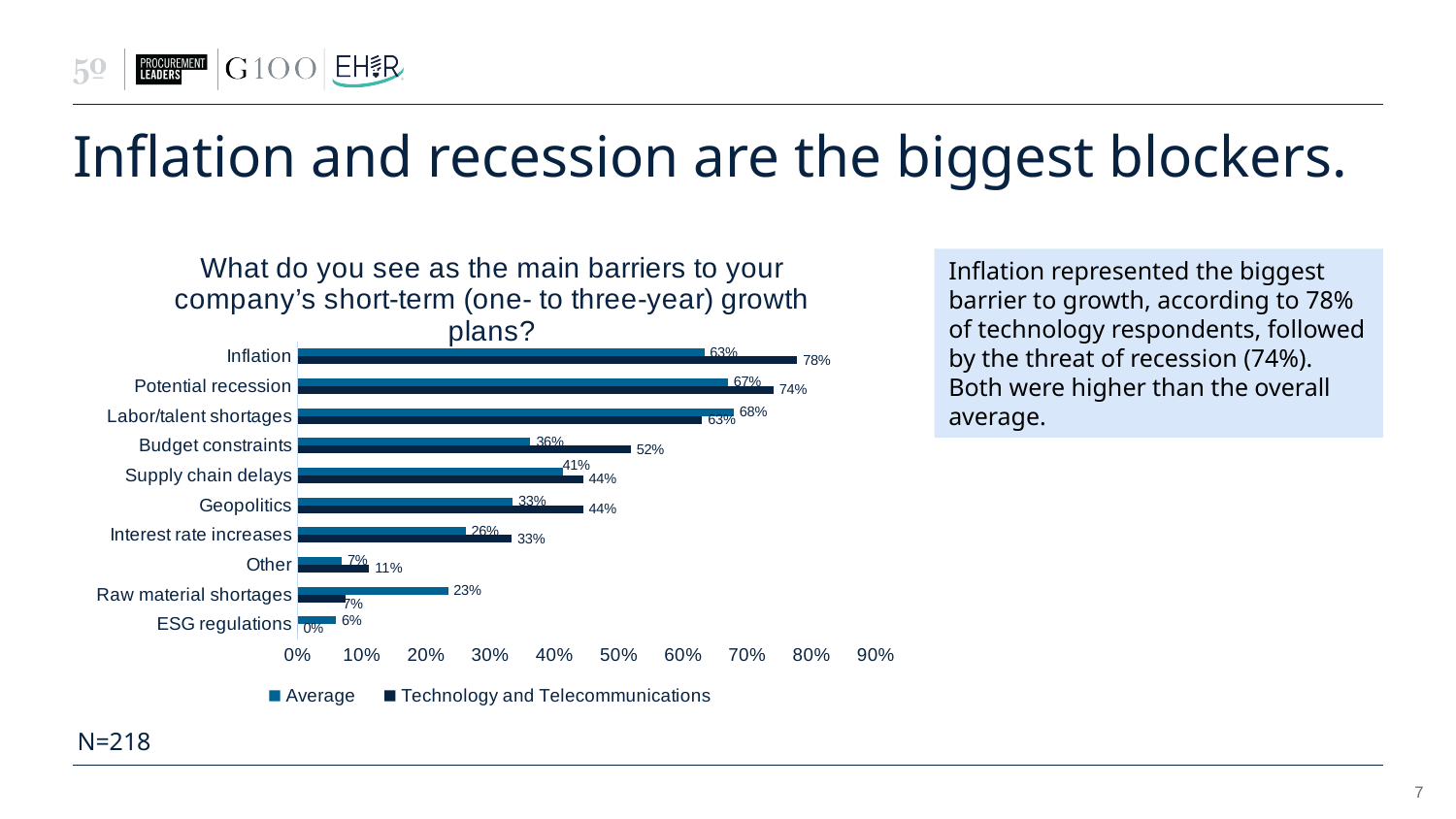
Which barrier has the highest Technology and Telecommunications value? Inflation What kind of chart is shown on the slide? Bar chart What is the Average value for Raw material shortages? 23% What is the difference between the Technology and Telecommunications value and the Average value for Inflation? 15% What is the Technology and Telecommunications value for ESG regulations? 0% What is the Technology and Telecommunications value for Budget constraints? 52% How many barrier categories are shown in the chart? 10 What is the Average value for Potential recession? 67% How many series does the legend list? 2 Which barrier has the lowest Average value? ESG regulations For Labor/talent shortages, which is larger: the Average value or the Technology and Telecommunications value? Average What is the Technology and Telecommunications value for Inflation? 78%